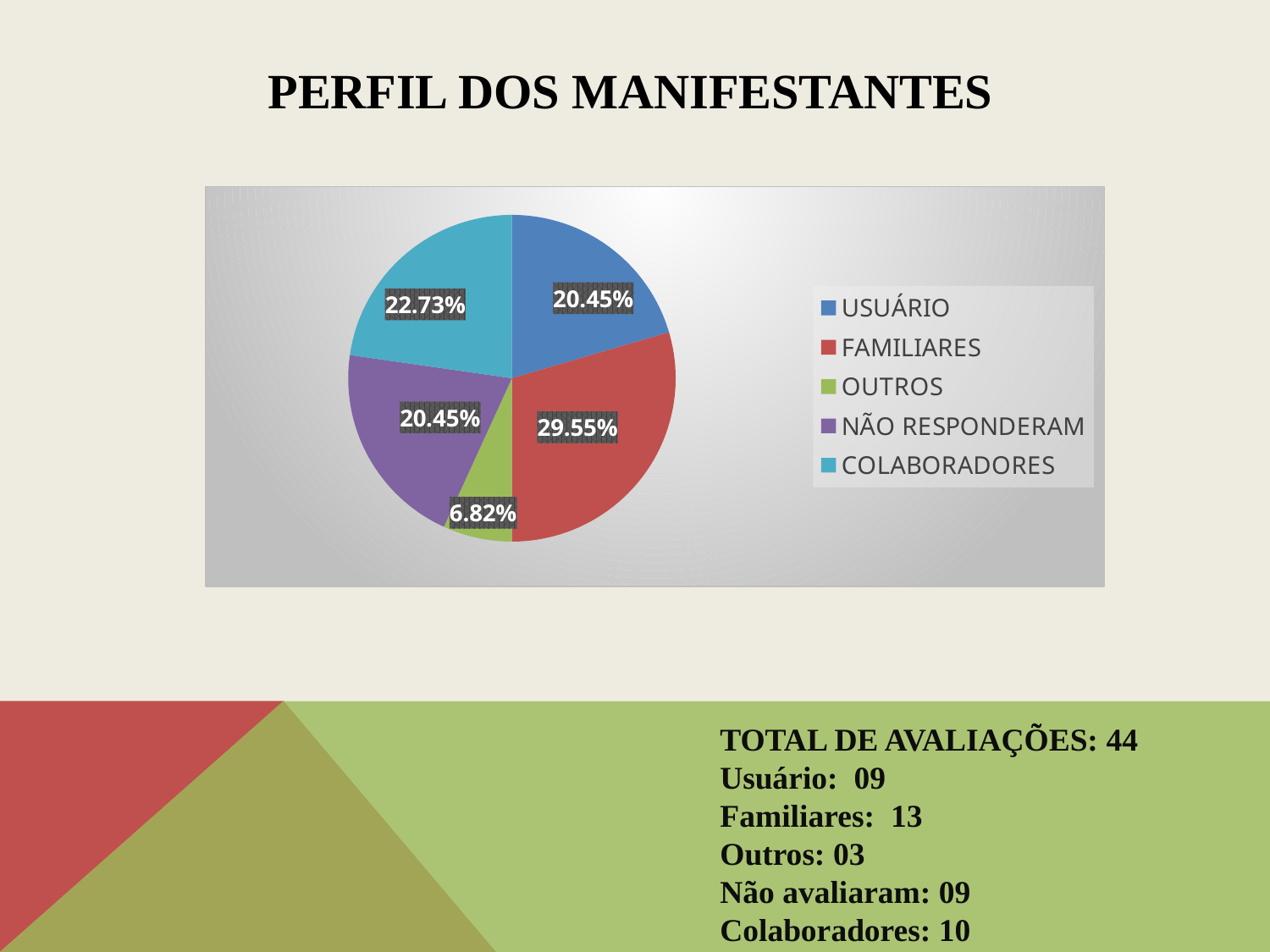
Which category has the largest slice of the pie? FAMILIARES What is the difference in percentage points between the FAMILIARES slice and the OUTROS slice? 22.73 What share of the pie does USUÁRIO represent? 20.45% How many slices does the pie chart have? 5 What type of chart is shown on the slide? Pie chart What is the title of the slide containing the chart? PERFIL DOS MANIFESTANTES Which colour represents NÃO RESPONDERAM in the legend? Purple What share of the pie does COLABORADORES represent? 22.73% What share of the pie does FAMILIARES represent? 29.55% Which category has the smallest slice of the pie? OUTROS Which slice is larger, COLABORADORES or USUÁRIO? COLABORADORES What share of the pie does OUTROS represent? 6.82%